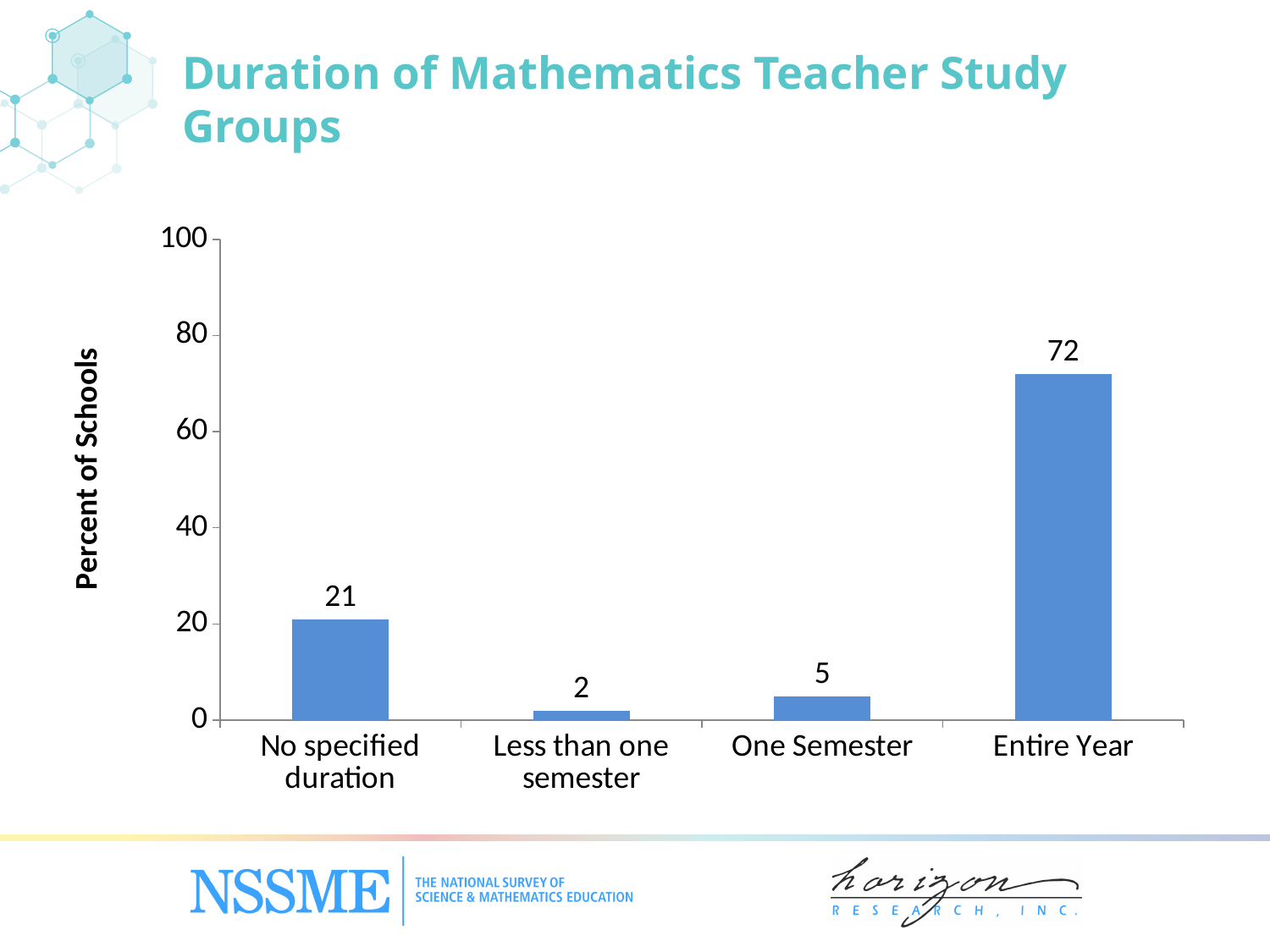
What is the difference between the values for 'Entire Year' and 'No specified duration'? 51 Which duration category has the lowest percent of schools? Less than one semester Which is larger, the value for 'One Semester' or 'Less than one semester'? One Semester Which duration category has the highest percent of schools? Entire Year Is the value for 'Entire Year' greater or less than 60? greater What is the value for 'Less than one semester'? 2 What is the value for 'One Semester'? 5 What percent of schools reported an entire year duration for mathematics teacher study groups? 72 What is the value for 'No specified duration'? 21 How many duration categories are shown on the x axis? 4 What is the label of the y axis? Percent of Schools What kind of chart is shown on the slide? Bar chart